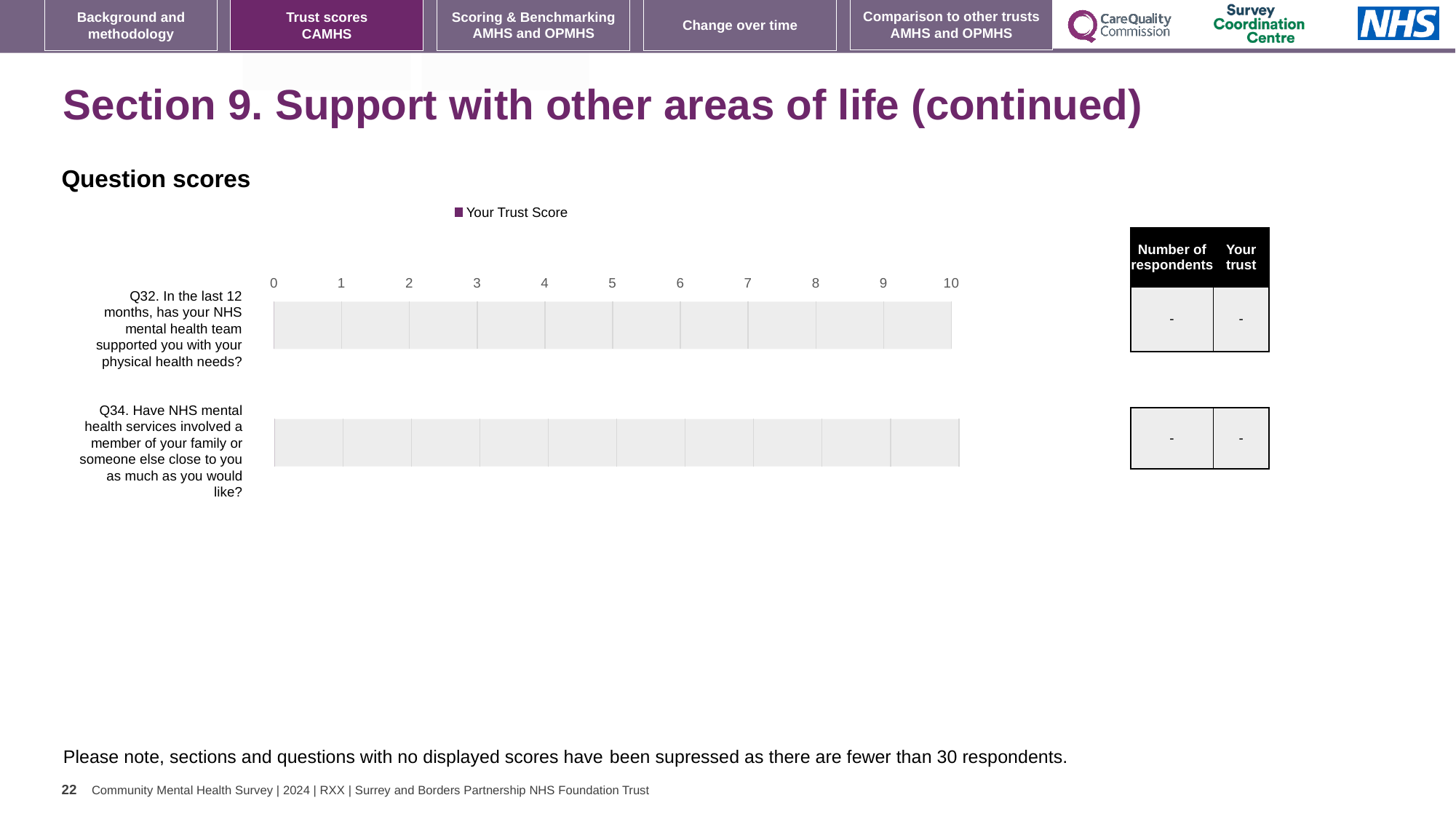
What is shown in the 'Number of respondents' column for Q32 next to the chart? - What is shown in the 'Number of respondents' column for Q34 next to the chart? - What kind of chart is shown under 'Question scores'? bar chart What is shown in the 'Your trust' column for Q34 next to the chart? - How many questions (categories) are listed on the 'Question scores' chart? 2 How many series does the legend of the 'Question scores' chart list? 1 What is the name of the series in the legend of the 'Question scores' chart? Your Trust Score What is the highest value shown on the x axis of the 'Question scores' chart? 10 What is shown in the 'Your trust' column for Q32 next to the chart? -